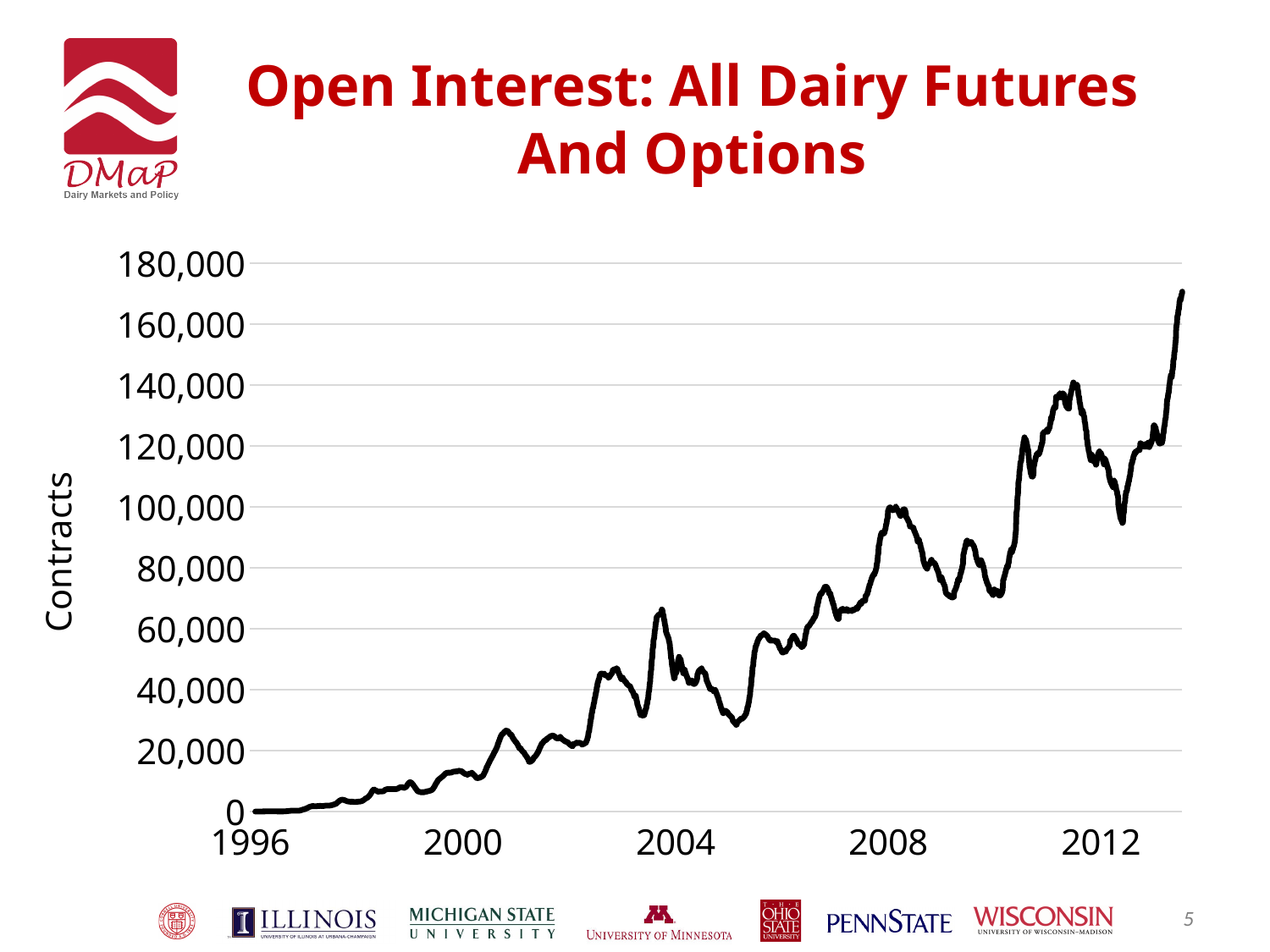
Does the line reach its highest value at the beginning or at the end of the period shown? end Overall, do the values rise or fall from 1996 to the end of the series? rise What kind of chart is shown on the slide? line chart Is the value at the start of 2000 greater or less than 20,000? less Is the highest value reached by the line greater or less than 160,000? greater What is the label on the vertical axis of the chart? Contracts Is the value at the start of 2008 larger or smaller than the value at the start of 2000? larger Is the value at the start of 2012 greater or less than 100,000? greater What is the title of the chart? Open Interest: All Dairy Futures And Options What is the highest value shown on the vertical axis? 180,000